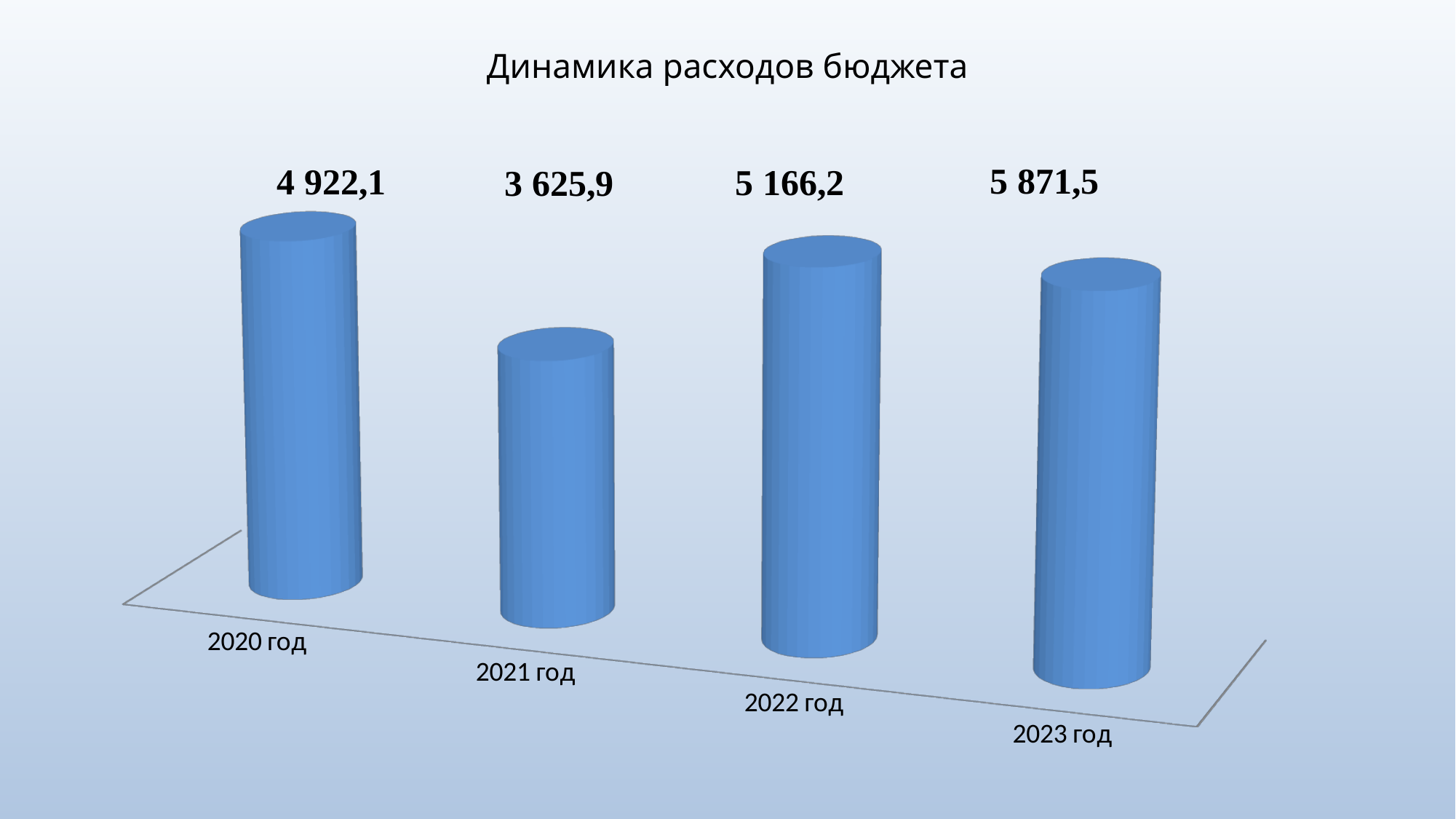
What is the value for 2021 год? 3 625,9 How many years are shown on the chart? 4 What is the value for 2022 год? 5 166,2 What kind of chart is this? bar chart What is the title of the chart? Динамика расходов бюджета Which year has the lowest value? 2021 год Which is larger, the value for 2020 год or the value for 2021 год? 2020 год What is the value for 2020 год? 4 922,1 What is the difference between the values for 2023 год and 2021 год? 2 245,6 What is the value for 2023 год? 5 871,5 What is the difference between the values for 2022 год and 2020 год? 244,1 Which year has the highest value? 2023 год